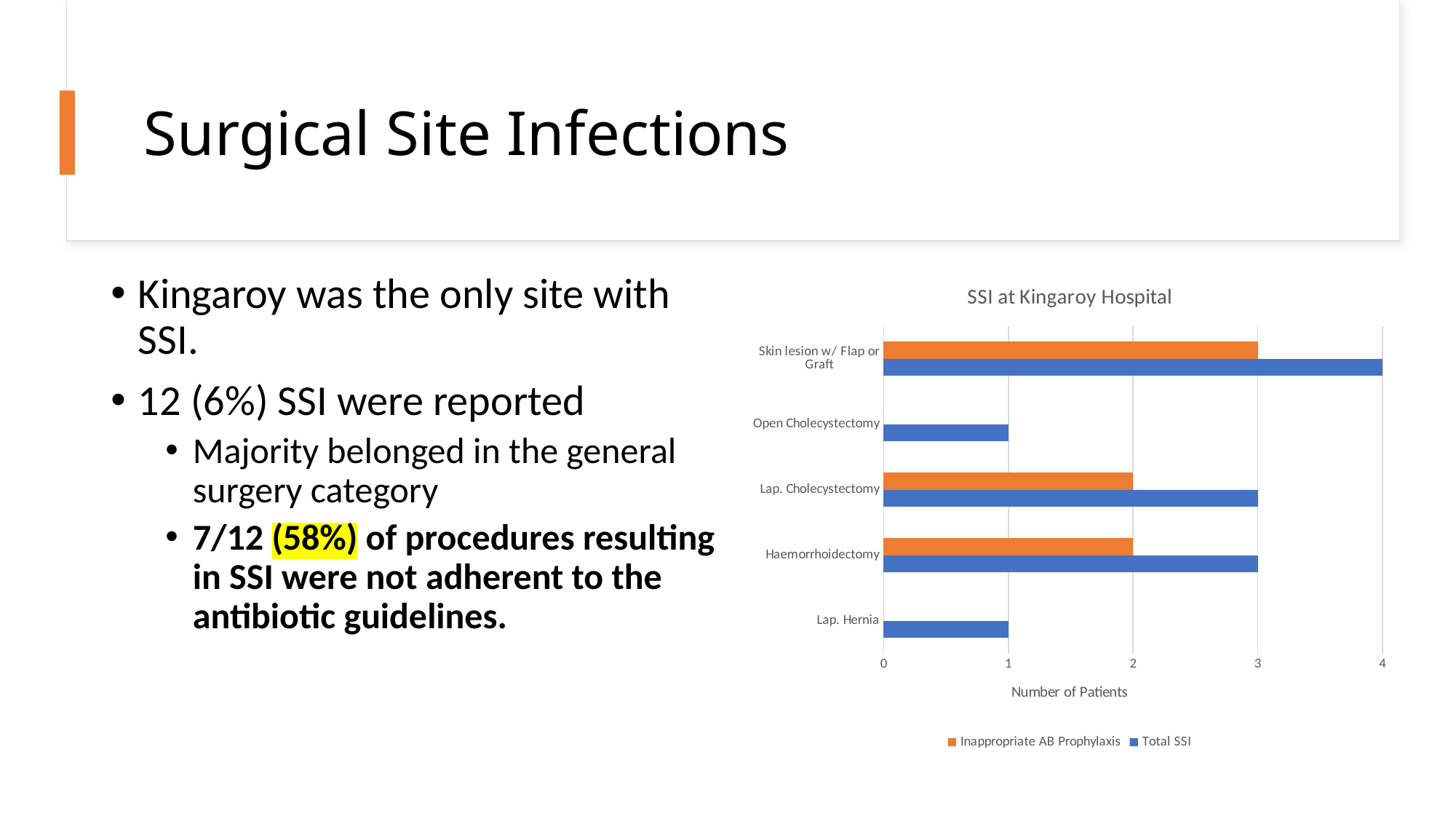
What is the difference between Total SSI and Inappropriate AB Prophylaxis for Haemorrhoidectomy? 1 What is the Total SSI value for Lap. Hernia? 1 What is the Inappropriate AB Prophylaxis value for Lap. Cholecystectomy? 2 Is the Total SSI value for Skin lesion w/ Flap or Graft greater or less than 3? greater Which is larger: the Total SSI for Open Cholecystectomy or the Total SSI for Lap. Cholecystectomy? Lap. Cholecystectomy What is the Total SSI value for Skin lesion w/ Flap or Graft? 4 What is the title of the chart? SSI at Kingaroy Hospital Which procedure has the highest Total SSI? Skin lesion w/ Flap or Graft How many series does the chart legend list? 2 How many procedure categories are shown on the chart? 5 What is the label of the horizontal axis? Number of Patients What type of chart is shown on the slide? bar chart